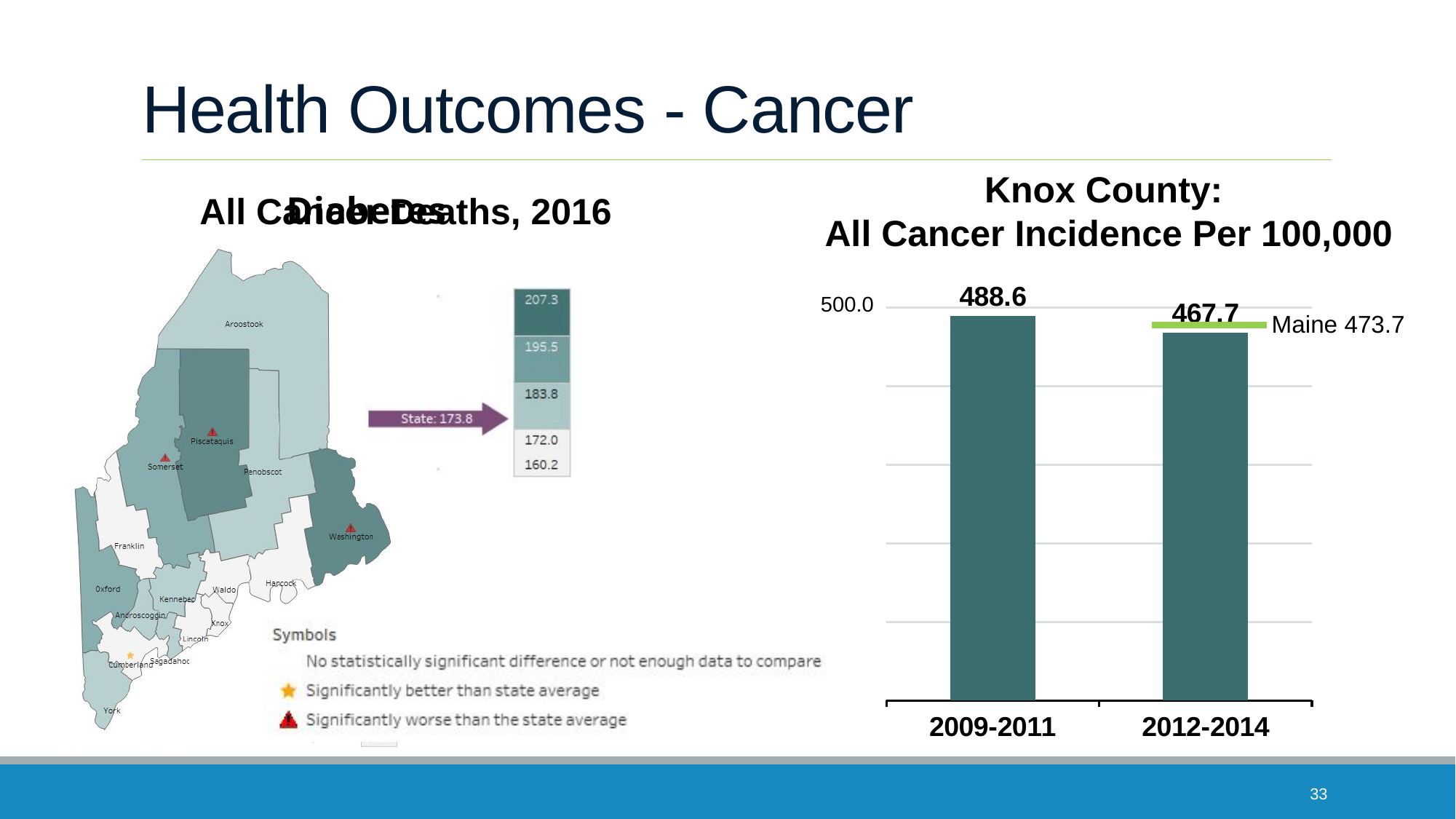
In the bar chart titled 'Knox County: All Cancer Incidence Per 100,000', what is the value for 2012-2014? 467.7 What kind of chart is the chart on the right of the slide titled 'Knox County: All Cancer Incidence Per 100,000'? bar chart In the Knox County cancer incidence bar chart, do the values rise or fall from 2009-2011 to 2012-2014? fall What is the title of the bar chart on the right side of the slide? Knox County: All Cancer Incidence Per 100,000 In the Knox County cancer incidence bar chart, which period has the highest value? 2009-2011 In the bar chart titled 'Knox County: All Cancer Incidence Per 100,000', what is the value for 2009-2011? 488.6 In the Knox County cancer incidence bar chart, what is the difference between the 2009-2011 value and the 2012-2014 value? 20.9 In the Knox County cancer incidence bar chart, which is larger: the value for 2009-2011 or the value for 2012-2014? 2009-2011 In the Knox County cancer incidence bar chart, which period has the lowest value? 2012-2014 In the Knox County cancer incidence bar chart, what Maine value is marked by the green reference line? 473.7 In the Knox County cancer incidence bar chart, is the value for 2012-2014 greater or less than 500.0? less How many periods (bars) are shown in the Knox County cancer incidence bar chart? 2